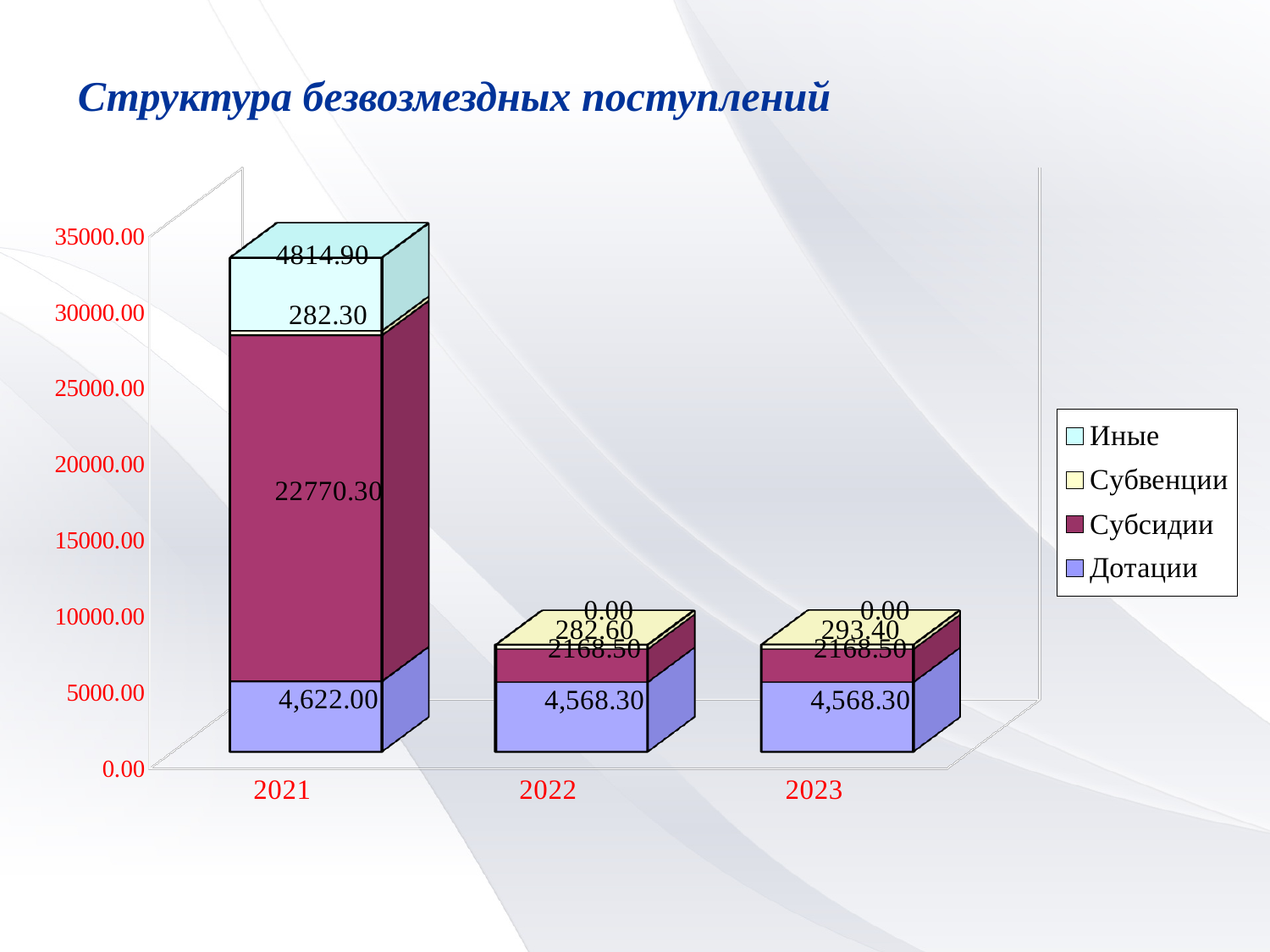
What is the value of Субсидии for 2021? 22770.30 What is the value of Субвенции for 2023? 293.40 What is the difference between the Субсидии values for 2021 and 2022? 20601.80 Is the Дотации value for 2021 larger or smaller than the Дотации value for 2023? larger What is the value of Иные for 2021? 4814.90 Which year has the lowest value for Дотации? 2022 and 2023 (both 4,568.30) What is the value of Дотации for 2022? 4,568.30 How many years are shown on the x axis? 3 What is the total of the stacked bar for 2022? 7019.40 What kind of chart is shown on the slide? stacked bar chart Which year has the highest value for Субсидии? 2021 How many series does the legend list? 4